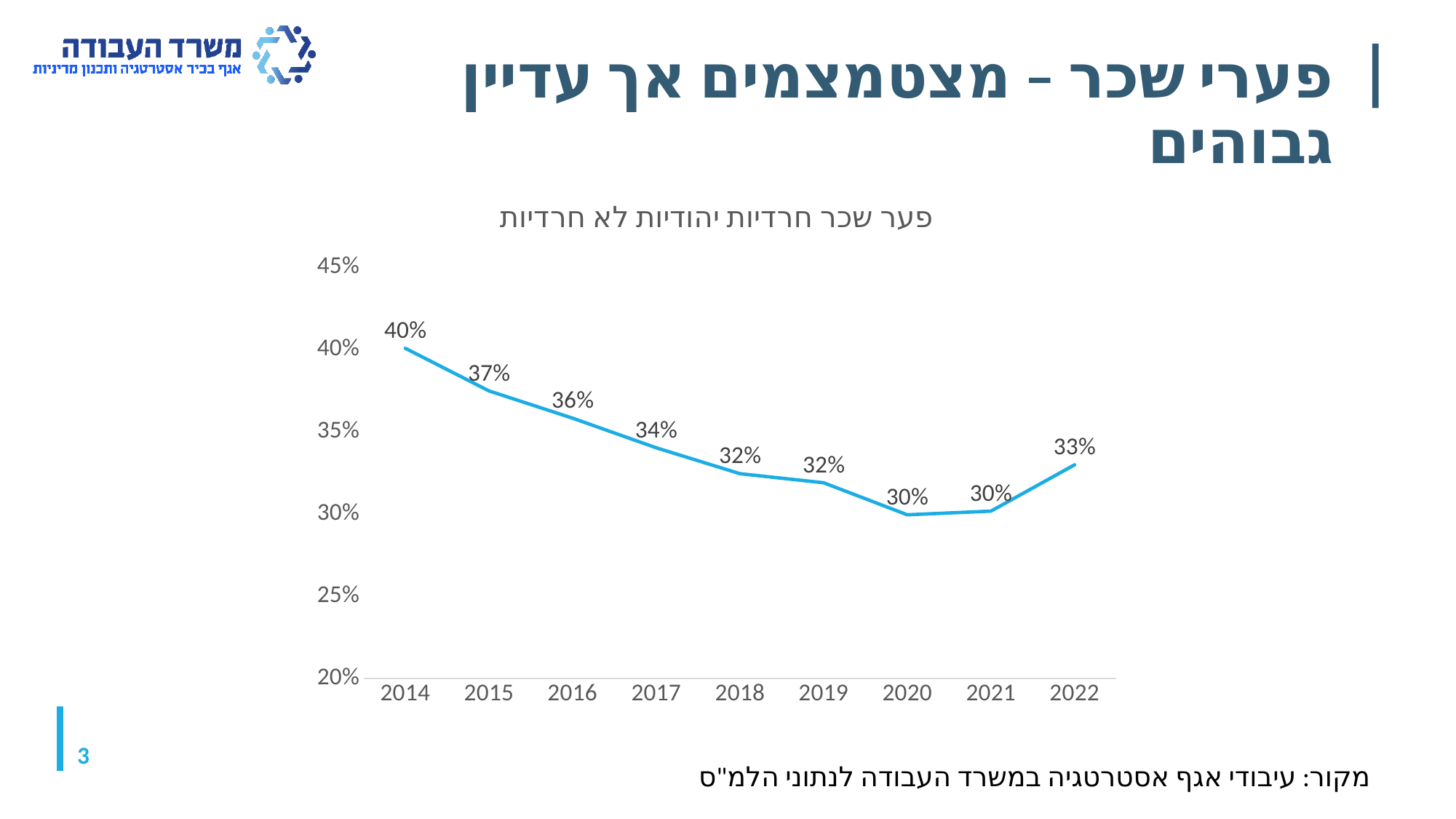
What is the value for 2014? 40% Do the values rise or fall from 2014 to 2020? fall What kind of chart is this? line chart What is the difference between the values for 2014 and 2022? 7% Which year has the highest value? 2014 How many years are shown on the x axis? 9 Which is larger, the value for 2015 or the value for 2021? 2015 What is the title of the chart? פער שכר חרדיות יהודיות לא חרדיות What is the value for 2022? 33% Is the value for 2016 greater or less than 35%? greater What is the lowest value shown on the chart? 30% What is the value for 2017? 34%